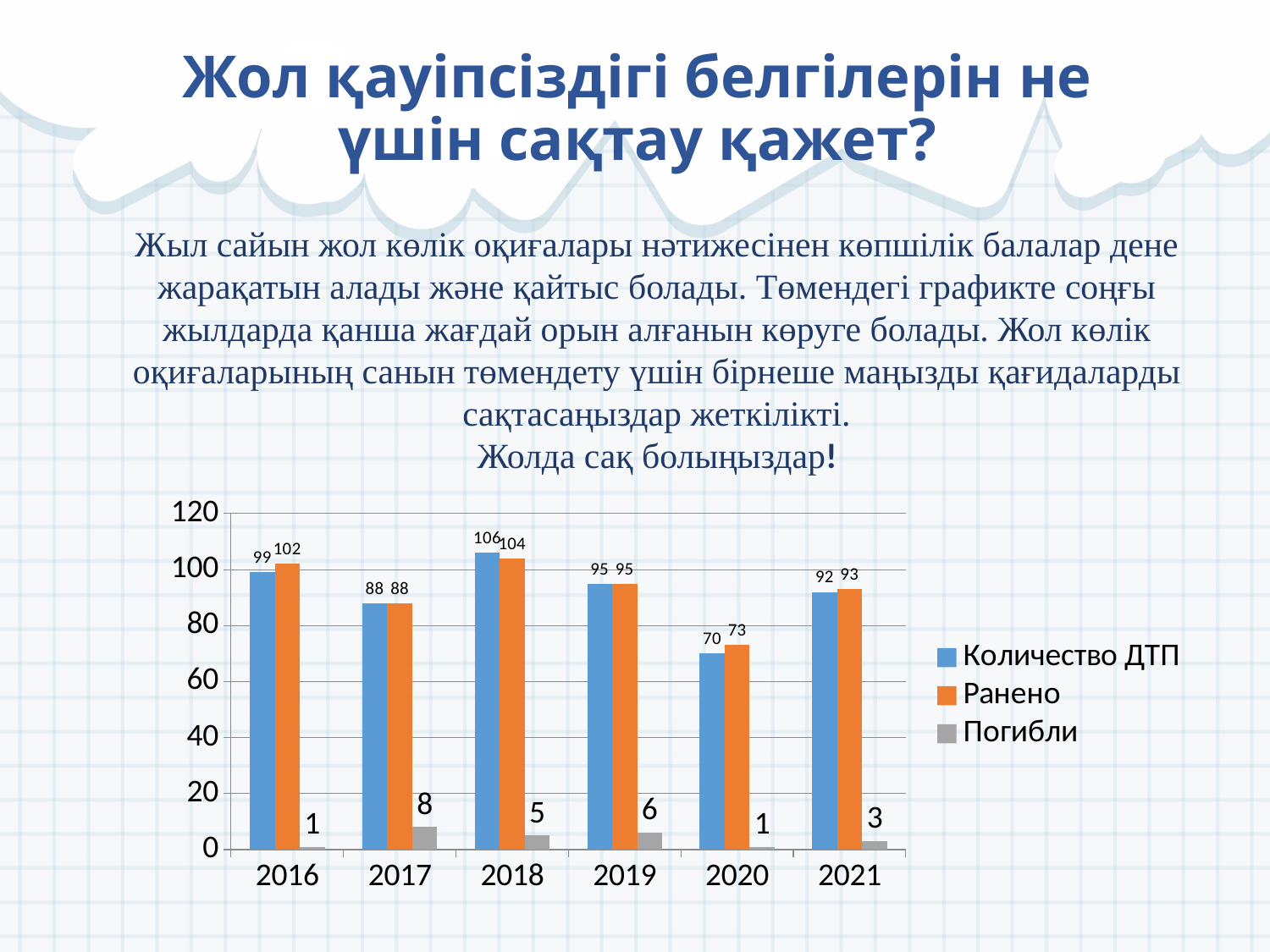
Which is larger in 2021: Количество ДТП or Ранено? Ранено Does Количество ДТП rise or fall from 2018 to 2020? fall What is the value of Ранено for 2020? 73 What type of chart is shown on the slide? bar chart How many series does the legend list? 3 In which year is Ранено the lowest? 2020 In which year is Количество ДТП the highest? 2018 What is the value of Погибли for 2017? 8 How many years are shown on the x axis of the chart? 6 What is the difference between Ранено and Количество ДТП in 2016? 3 Which series is shown in orange in the legend? Ранено What is the value of Количество ДТП for 2018? 106